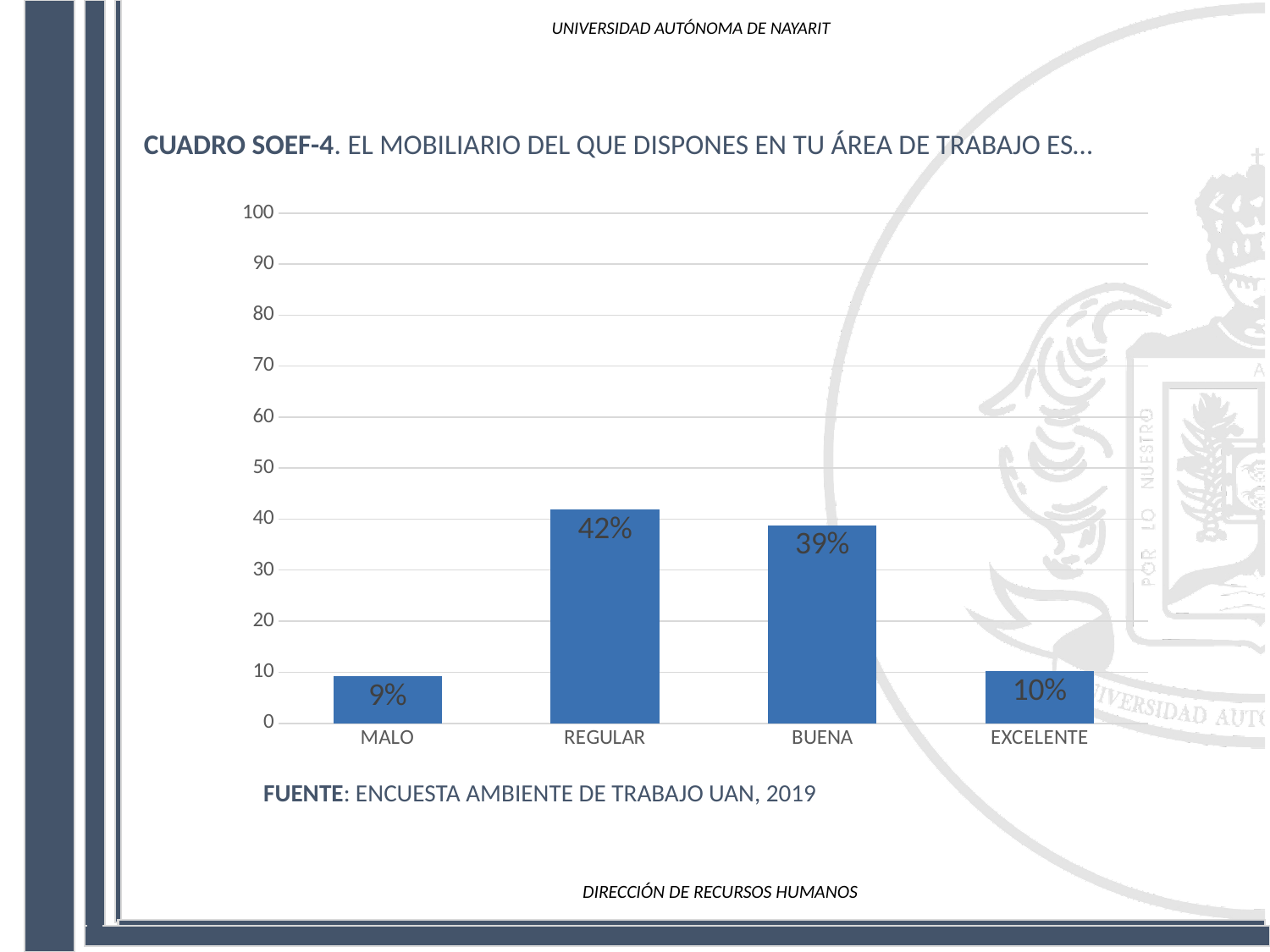
What is the value for MALO? 9% How many categories are shown on the x axis? 4 Which is larger, the value for BUENA or the value for EXCELENTE? BUENA What kind of chart is shown on the slide? bar chart What is the value for EXCELENTE? 10% Is the value for REGULAR greater or less than 40? greater What is the difference between the values for EXCELENTE and MALO? 1% What is the value for REGULAR? 42% Which category has the lowest value? MALO What is the value for BUENA? 39% What is the difference between the values for REGULAR and BUENA? 3% Which category has the highest value? REGULAR